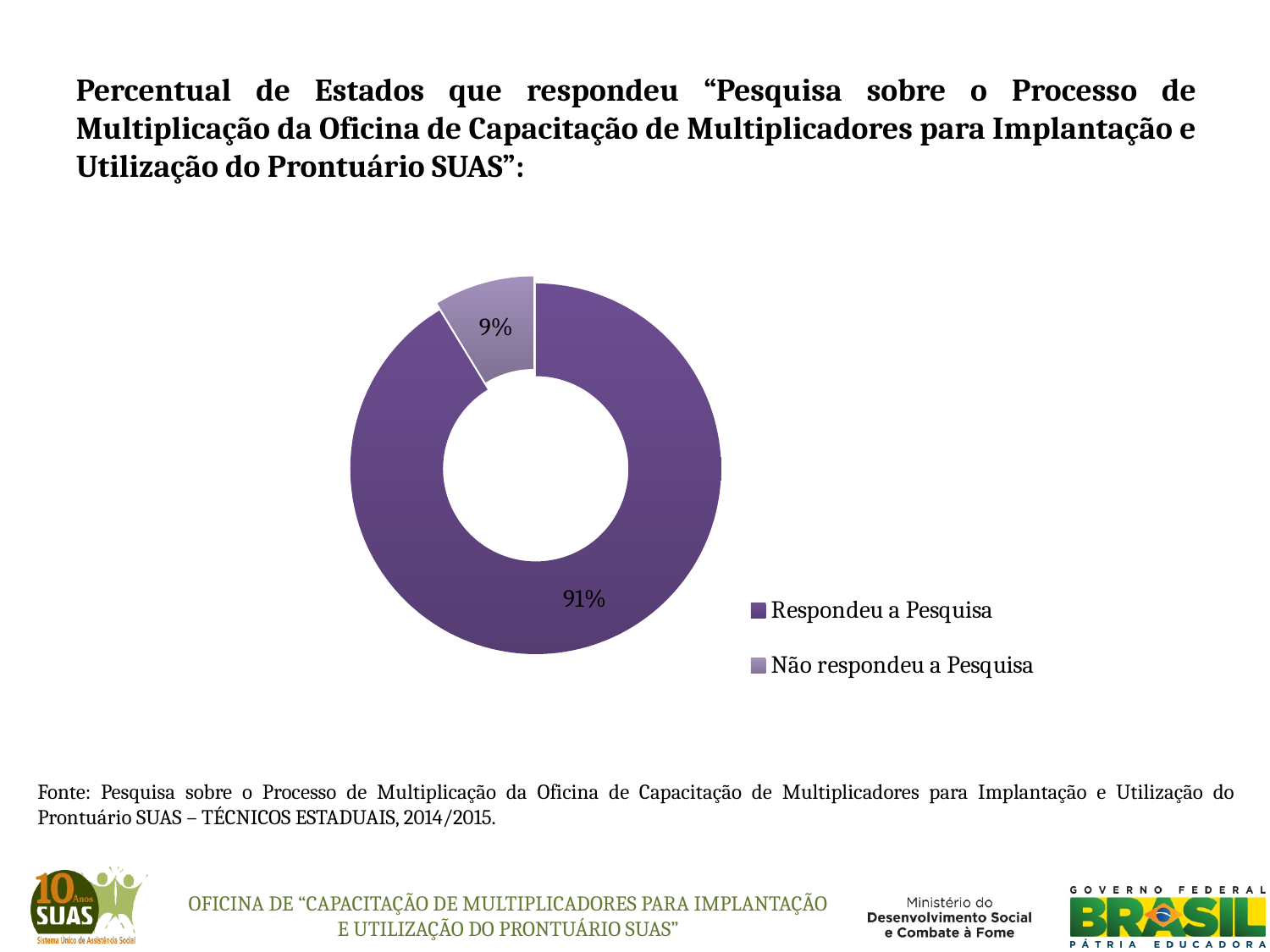
Which category has the largest share of the chart? Respondeu a Pesquisa What percentage of states is shown for "Respondeu a Pesquisa"? 91% Which legend entry is shown in the lighter purple colour? Não respondeu a Pesquisa Which category has the smallest share of the chart? Não respondeu a Pesquisa What is the difference in percentage points between "Respondeu a Pesquisa" and "Não respondeu a Pesquisa"? 82 How many entries does the legend list? 2 Is the share for "Respondeu a Pesquisa" greater or less than 50%? greater What kind of chart is shown on the slide? Doughnut (pie) chart How many categories does the chart show? 2 Which is larger: the share for "Respondeu a Pesquisa" or for "Não respondeu a Pesquisa"? Respondeu a Pesquisa What percentage of states is shown for "Não respondeu a Pesquisa"? 9% What share of the chart does the "Não respondeu a Pesquisa" slice represent? 9%